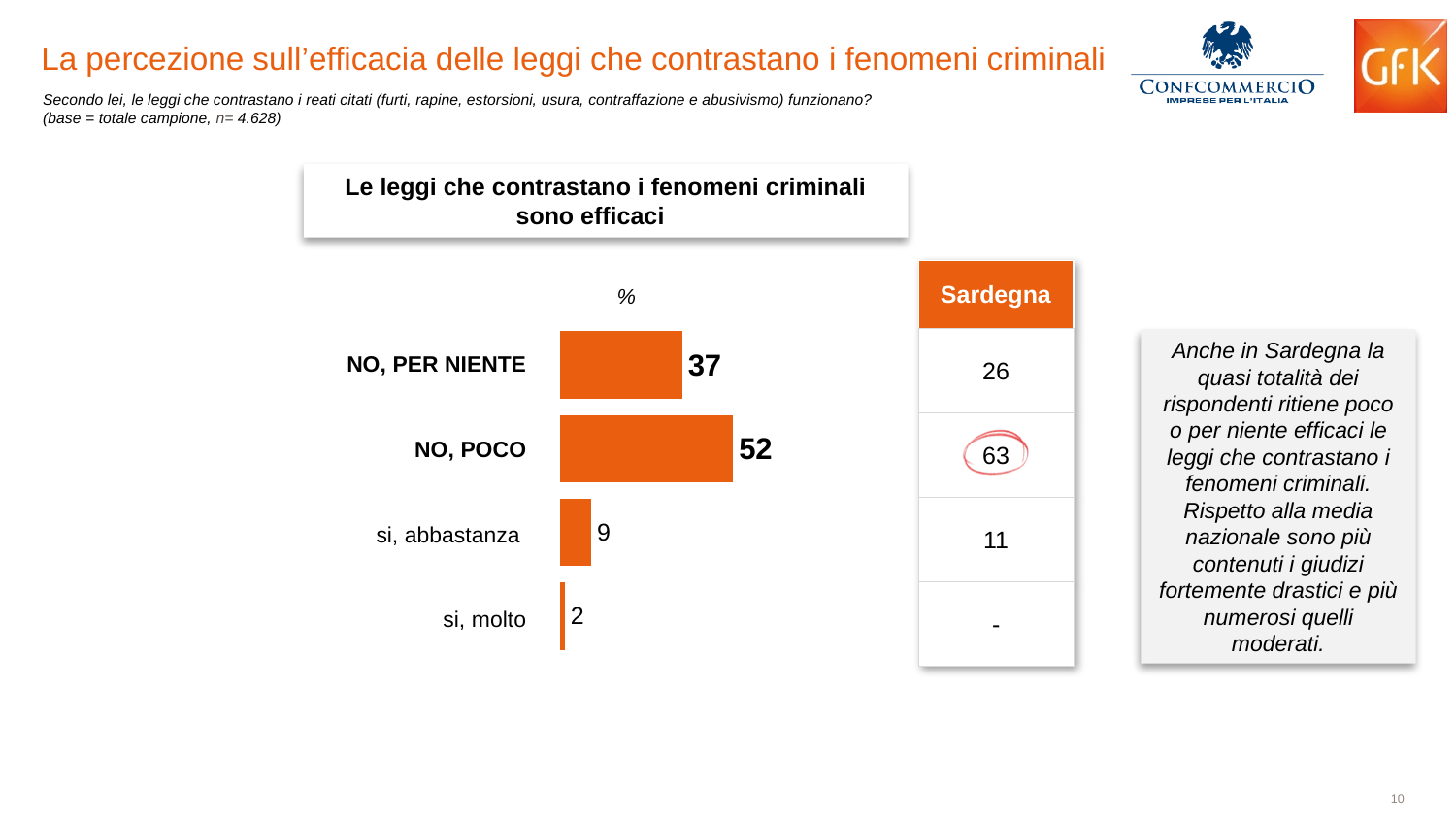
Which category has the lowest value in the bar chart? si, molto What is the value for "si, abbastanza" in the bar chart? 9 What is the value for "si, molto" in the bar chart? 2 What is the value for "NO, PER NIENTE" in the bar chart? 37 Which is larger, the value for "si, abbastanza" or the value for "si, molto"? si, abbastanza How many categories are shown in the bar chart? 4 What kind of chart is shown on the slide? Bar chart What is the difference between the values for "NO, POCO" and "NO, PER NIENTE"? 15 What unit is indicated above the bars in the chart? % What is the title of the chart? Le leggi che contrastano i fenomeni criminali sono efficaci Which category has the highest value in the bar chart? NO, POCO What is the value for "NO, POCO" in the bar chart? 52